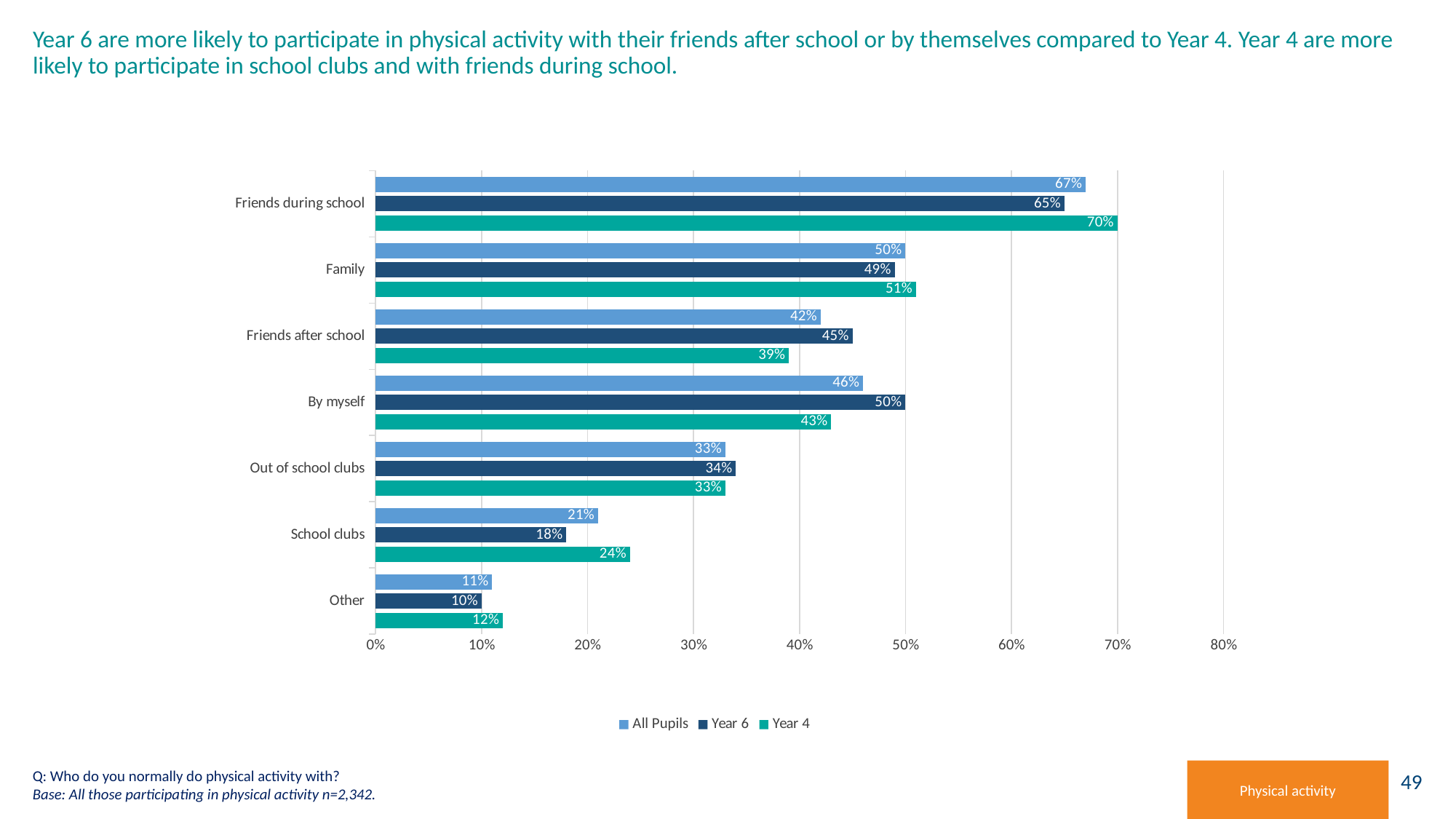
Is the Year 4 value for Family greater or less than 40%? greater Which category has the lowest All Pupils value? Other What is the Year 6 value for By myself? 50% What kind of chart is shown on the slide? Bar chart Which is larger for Friends after school: the Year 6 value or the Year 4 value? Year 6 What is the Year 4 value for Friends during school? 70% How many categories are shown on the y axis? 7 What is the difference between the Year 4 and Year 6 values for School clubs? 6% What is the All Pupils value for School clubs? 21% Which series is shown in the darkest blue colour? Year 6 Which category has the highest Year 6 value? Friends during school How many series does the legend list? 3